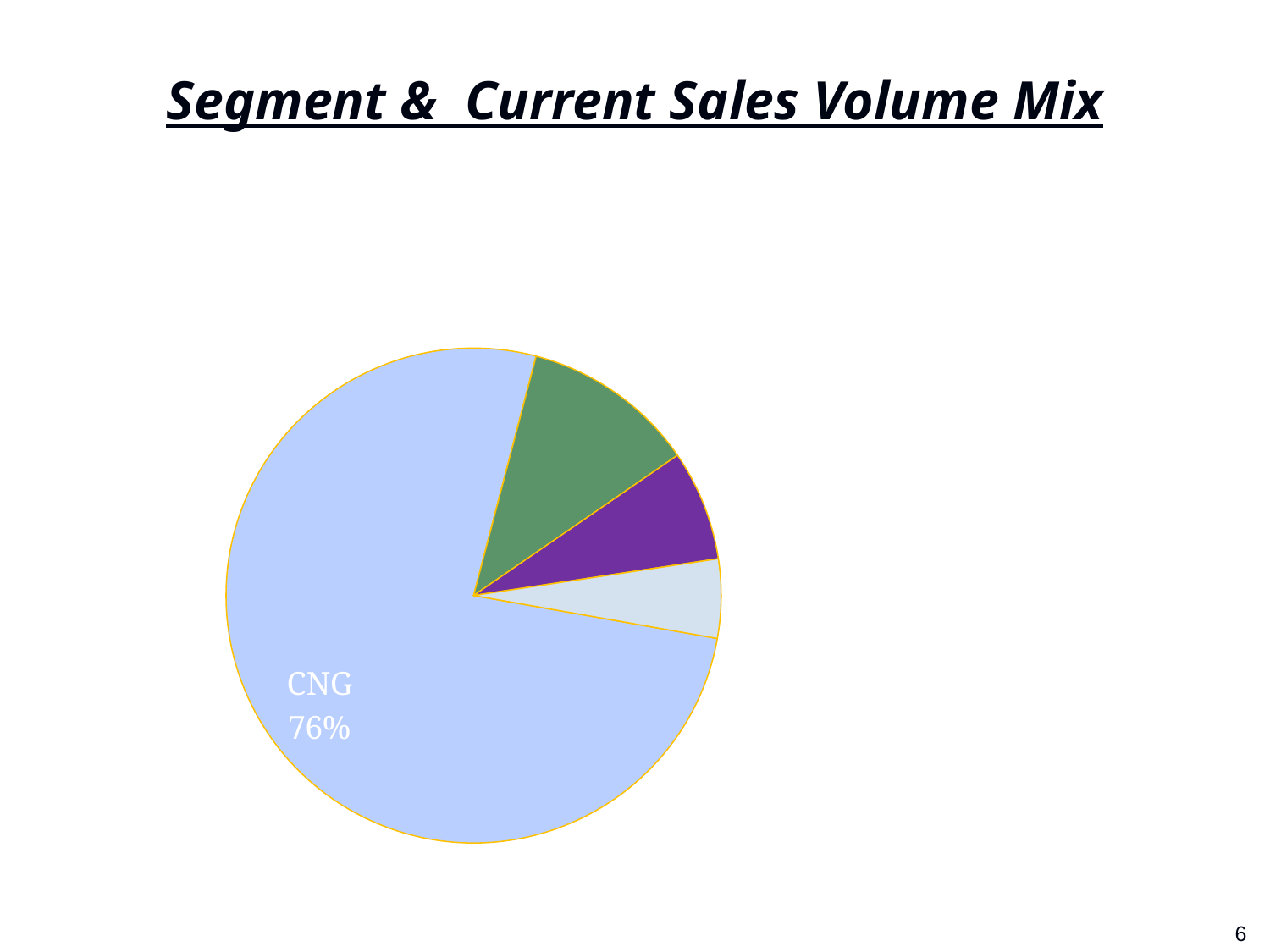
Which is larger, the CNG slice or the green slice? CNG What is the title of the slide containing the pie chart? Segment & Current Sales Volume Mix How many slices in the pie chart have a printed data label? 1 How many slices does the pie chart have? 4 Is the CNG share greater or less than 50%? greater What kind of chart is shown on the slide? pie chart What colour is the CNG slice in the pie chart? light blue Which slice is the largest in the pie chart? CNG What share of the pie does the CNG slice represent? 76%